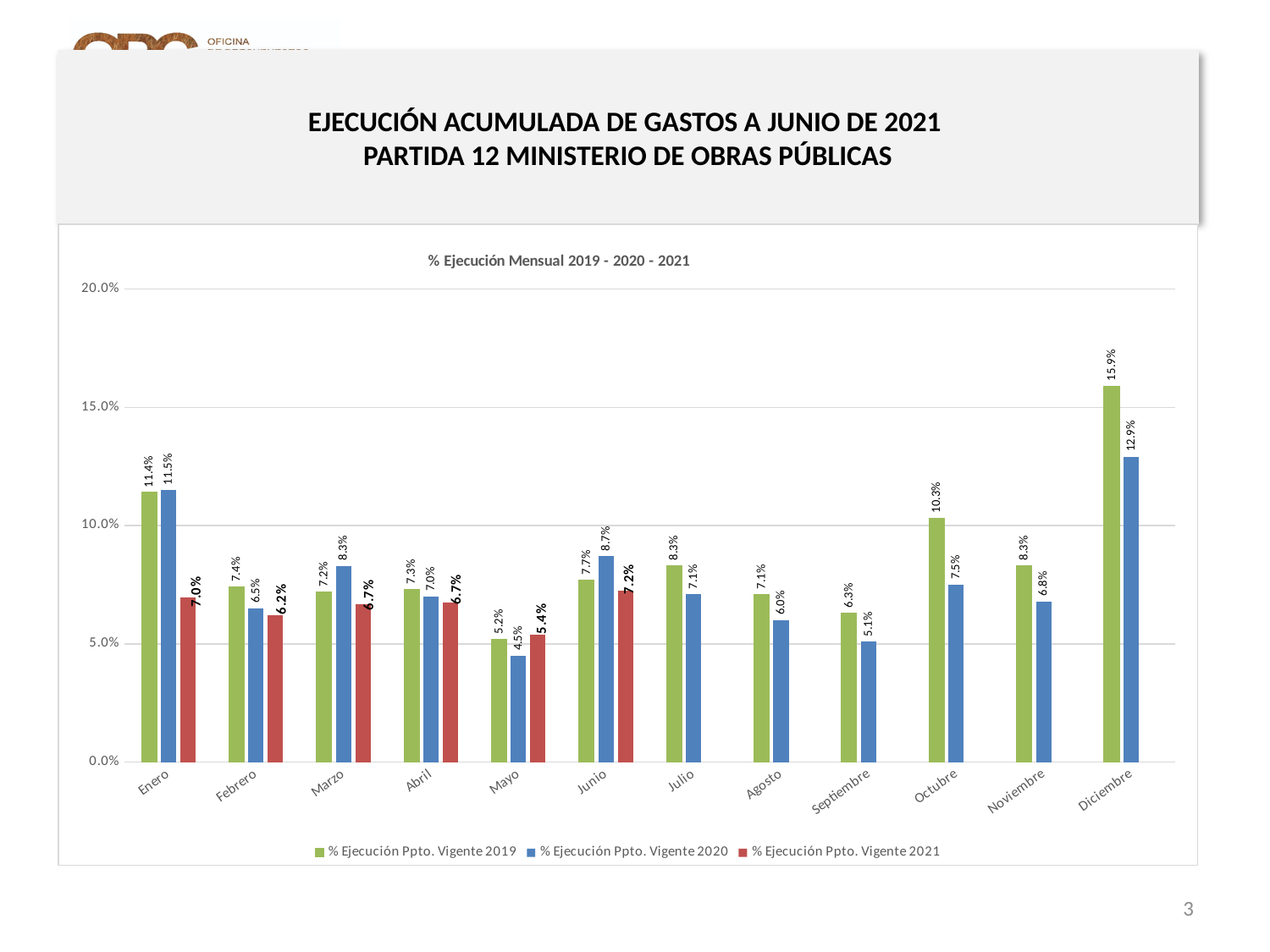
What is the difference between the 2019 and 2020 values for Diciembre? 3.0% Which month has the highest value in the % Ejecución Ppto. Vigente 2020 series? Diciembre How many months are shown on the x axis? 12 What is the value for Junio in the % Ejecución Ppto. Vigente 2021 series? 7.2% What is the value for Diciembre in the % Ejecución Ppto. Vigente 2019 series? 15.9% Which is larger for Marzo: the 2019 value or the 2020 value? 2020 value (8.3%) What kind of chart is shown on the slide? Bar chart What is the value for Mayo in the % Ejecución Ppto. Vigente 2020 series? 4.5% Which month has the lowest value in the % Ejecución Ppto. Vigente 2019 series? Mayo What is the title of the chart? % Ejecución Mensual 2019 - 2020 - 2021 How many series does the legend list? 3 Is the value for Octubre in the 2019 series greater or less than 10.0%? greater